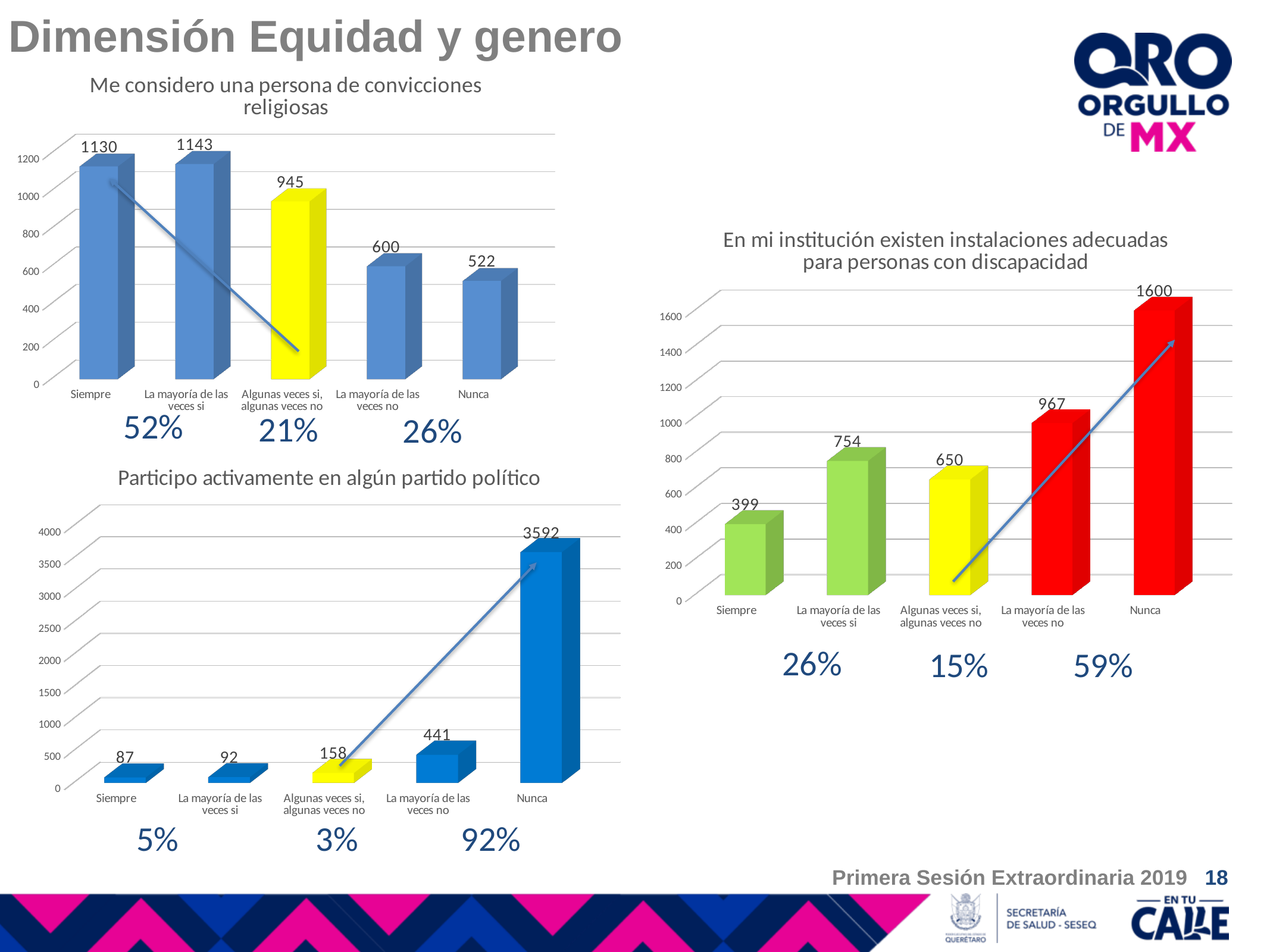
In the chart 'En mi institución existen instalaciones adecuadas para personas con discapacidad', what is the difference between 'Nunca' and 'La mayoría de las veces no'? 633 In the chart 'Participo activamente en algún partido político', how many categories are shown on the x axis? 5 In the chart 'Me considero una persona de convicciones religiosas', which category has the lowest value? Nunca In the chart 'En mi institución existen instalaciones adecuadas para personas con discapacidad', what is the value for 'La mayoría de las veces si'? 754 What kind of chart is 'En mi institución existen instalaciones adecuadas para personas con discapacidad'? Bar chart In the chart 'Me considero una persona de convicciones religiosas', what is the value for 'Siempre'? 1130 In the chart 'Participo activamente en algún partido político', which is larger, 'La mayoría de las veces no' or 'Algunas veces si, algunas veces no'? La mayoría de las veces no In the chart 'Me considero una persona de convicciones religiosas', which category has the highest value? La mayoría de las veces si In the chart 'Me considero una persona de convicciones religiosas', what is the difference between 'Algunas veces si, algunas veces no' and 'La mayoría de las veces no'? 345 In the chart 'Participo activamente en algún partido político', which category has the lowest value? Siempre In the chart 'En mi institución existen instalaciones adecuadas para personas con discapacidad', which category has the highest value? Nunca In the chart 'Participo activamente en algún partido político', what is the value for 'Nunca'? 3592